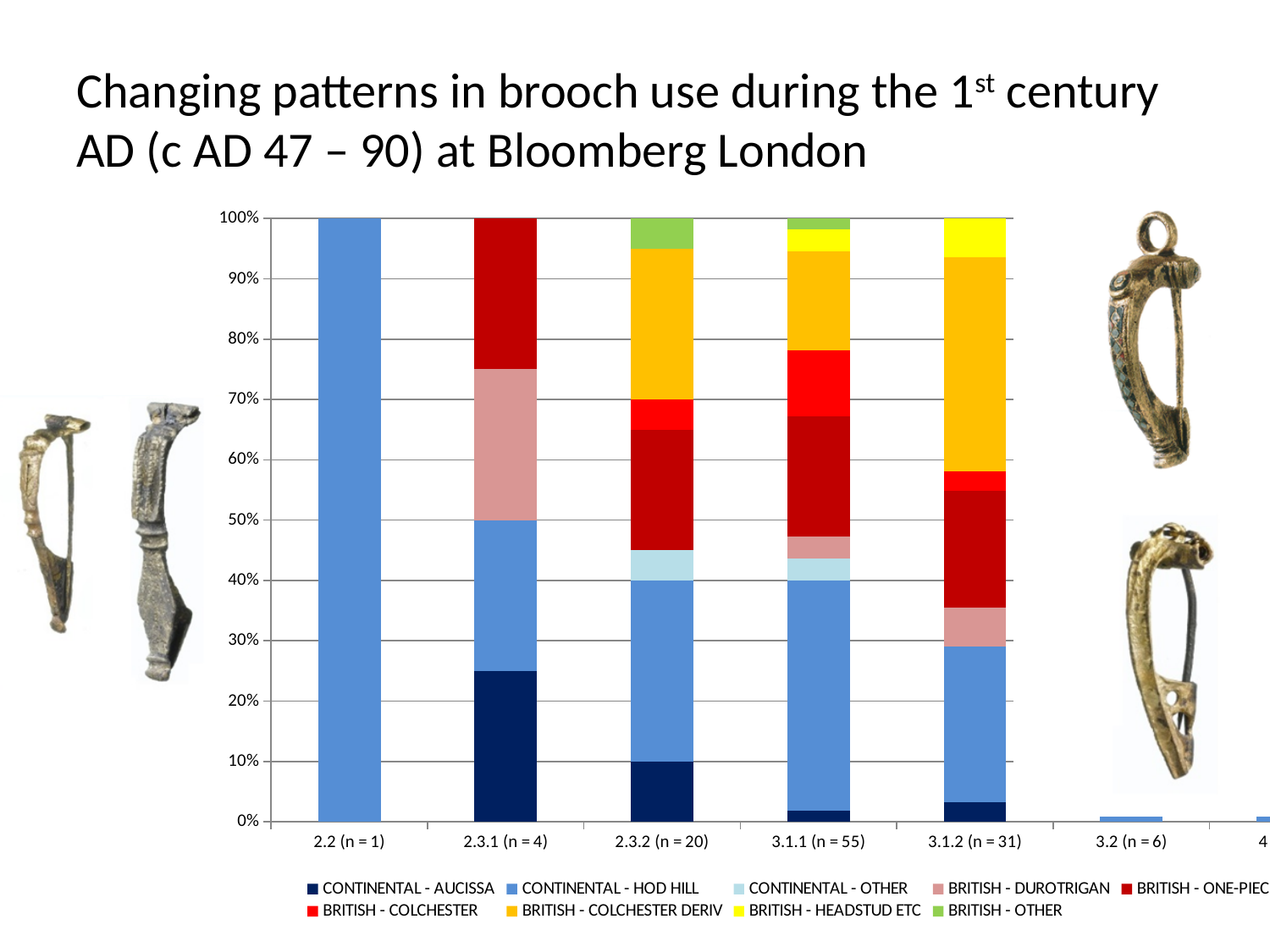
Which bar has the largest BRITISH - COLCHESTER DERIV share? 3.1.2 (n = 31) Is the BRITISH - COLCHESTER DERIV share in the 3.1.2 (n = 31) bar greater or less than 30%? greater What kind of chart is shown on the slide? Stacked bar chart Is the CONTINENTAL - AUCISSA share in the 2.3.1 (n = 4) bar greater or less than 20%? greater What share of the 2.3.2 (n = 20) bar is CONTINENTAL - AUCISSA? 10% What is the title of the slide containing the chart? Changing patterns in brooch use during the 1st century AD (c AD 47 – 90) at Bloomberg London Which bar has the larger CONTINENTAL - AUCISSA share, 2.3.1 (n = 4) or 2.3.2 (n = 20)? 2.3.1 (n = 4) What share of the 2.2 (n = 1) bar is CONTINENTAL - HOD HILL? 100% Does the CONTINENTAL - AUCISSA share rise or fall from 2.3.1 (n = 4) to 3.1.1 (n = 55)? fall Which bar has the largest CONTINENTAL - HOD HILL share? 2.2 (n = 1) Is the CONTINENTAL - AUCISSA share in the 3.1.1 (n = 55) bar greater or less than 10%? less How many series does the legend list? 9